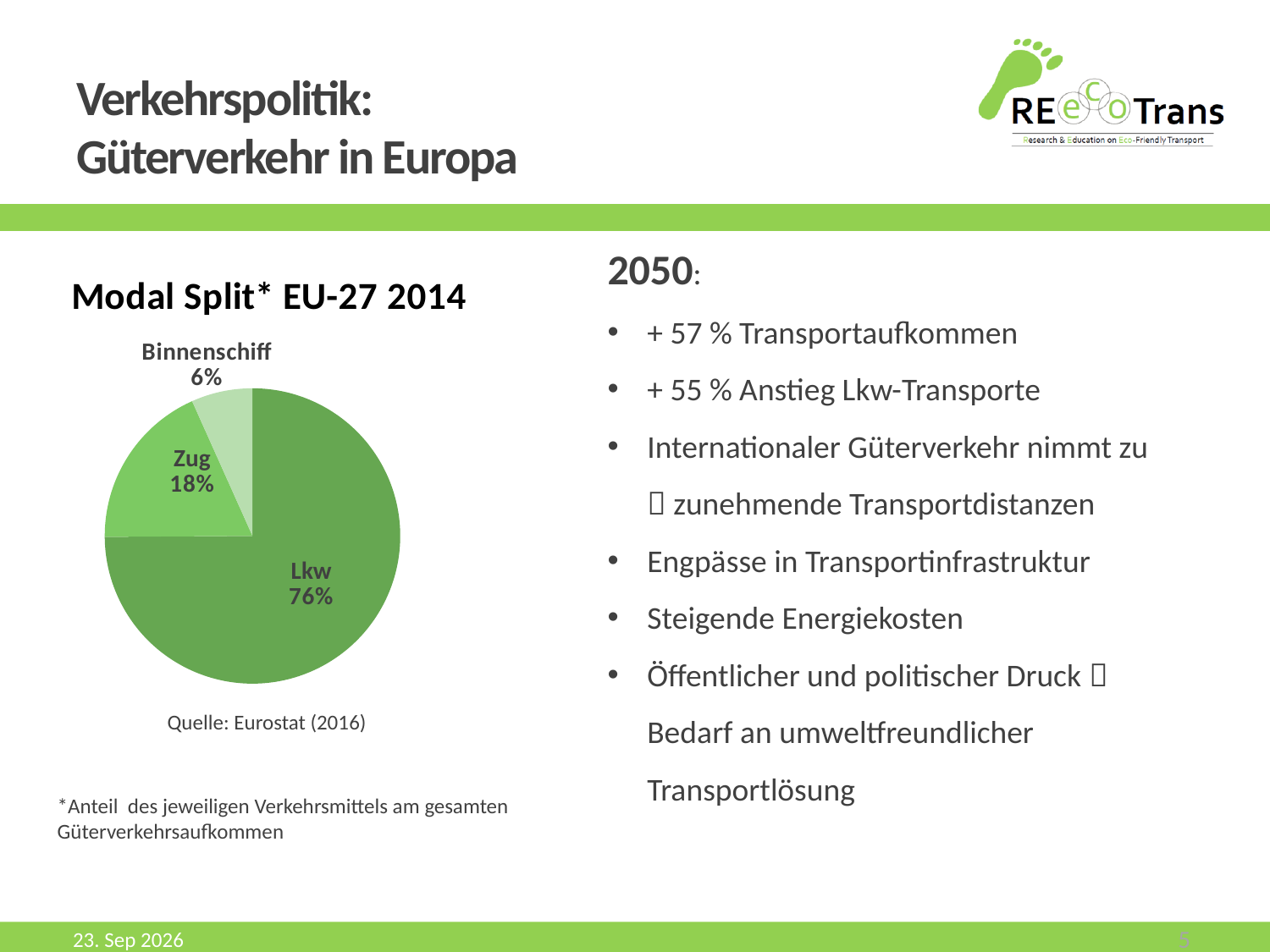
What share of the pie does Lkw have? 76% What source is cited below the chart? Quelle: Eurostat (2016) What share of the pie does Binnenschiff have? 6% What type of chart is shown on the slide? pie chart Which category has the largest share of the pie? Lkw What is the difference in percentage points between the Zug share and the Binnenschiff share? 12 What is the title of the chart? Modal Split* EU-27 2014 How many slices does the pie chart have? 3 Which is larger, the share for Zug or the share for Binnenschiff? Zug What is the difference in percentage points between the Lkw share and the Zug share? 58 What share of the pie does Zug have? 18% Which category has the smallest share of the pie? Binnenschiff